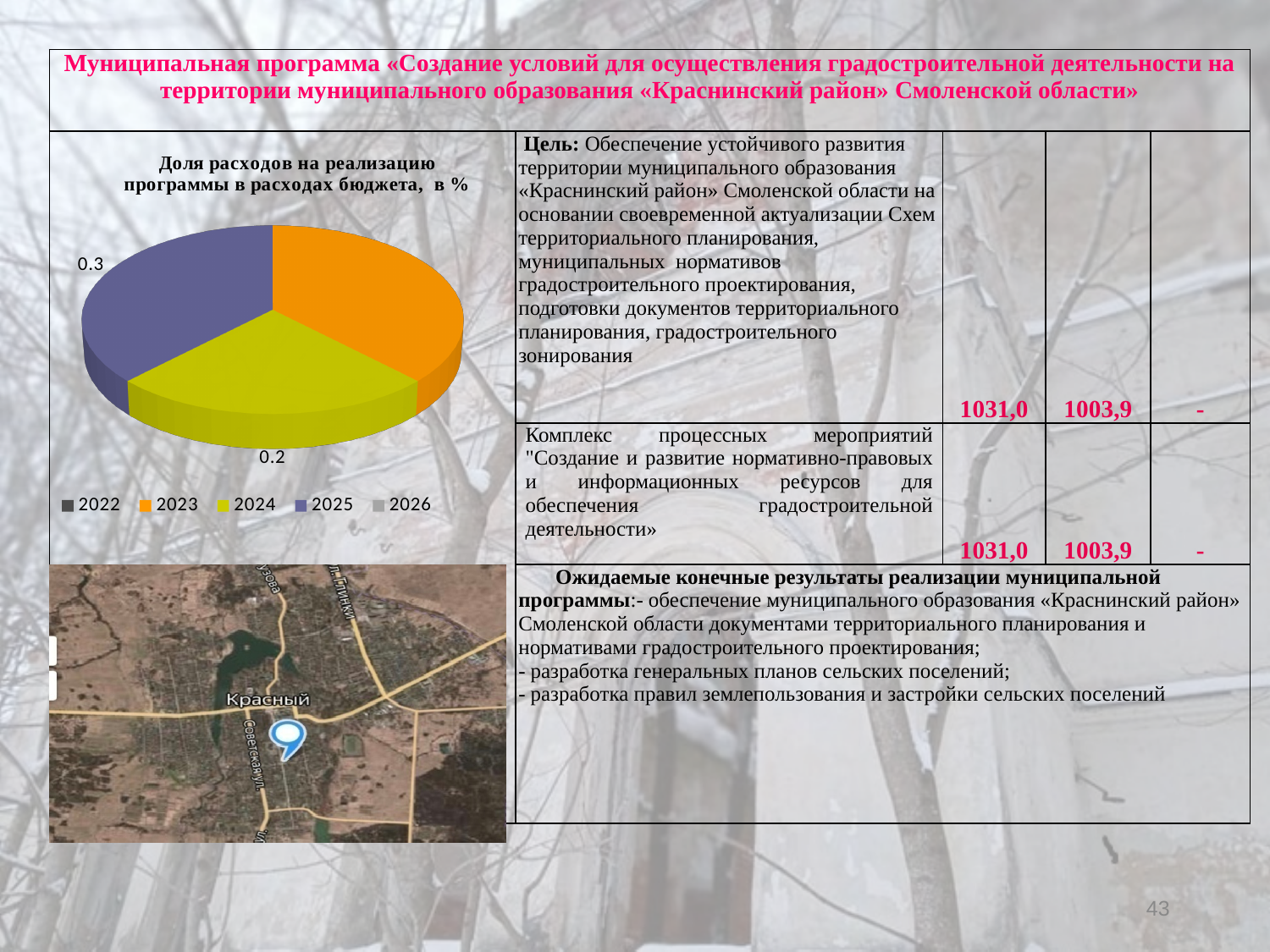
How many slices are visible in the pie chart? 3 How many entries does the legend of the pie chart list? 5 Which is larger in the pie chart, the value for 2025 or the value for 2024? 2025 What colour represents 2023 in the pie chart legend? orange What value is labelled for 2025 in the pie chart? 0.3 What value is labelled for 2024 in the pie chart? 0.2 What is the title of the pie chart? Доля расходов на реализацию программы в расходах бюджета, в % What kind of chart is shown on the slide? pie chart What is the difference between the labelled values for 2025 and 2024 in the pie chart? 0.1